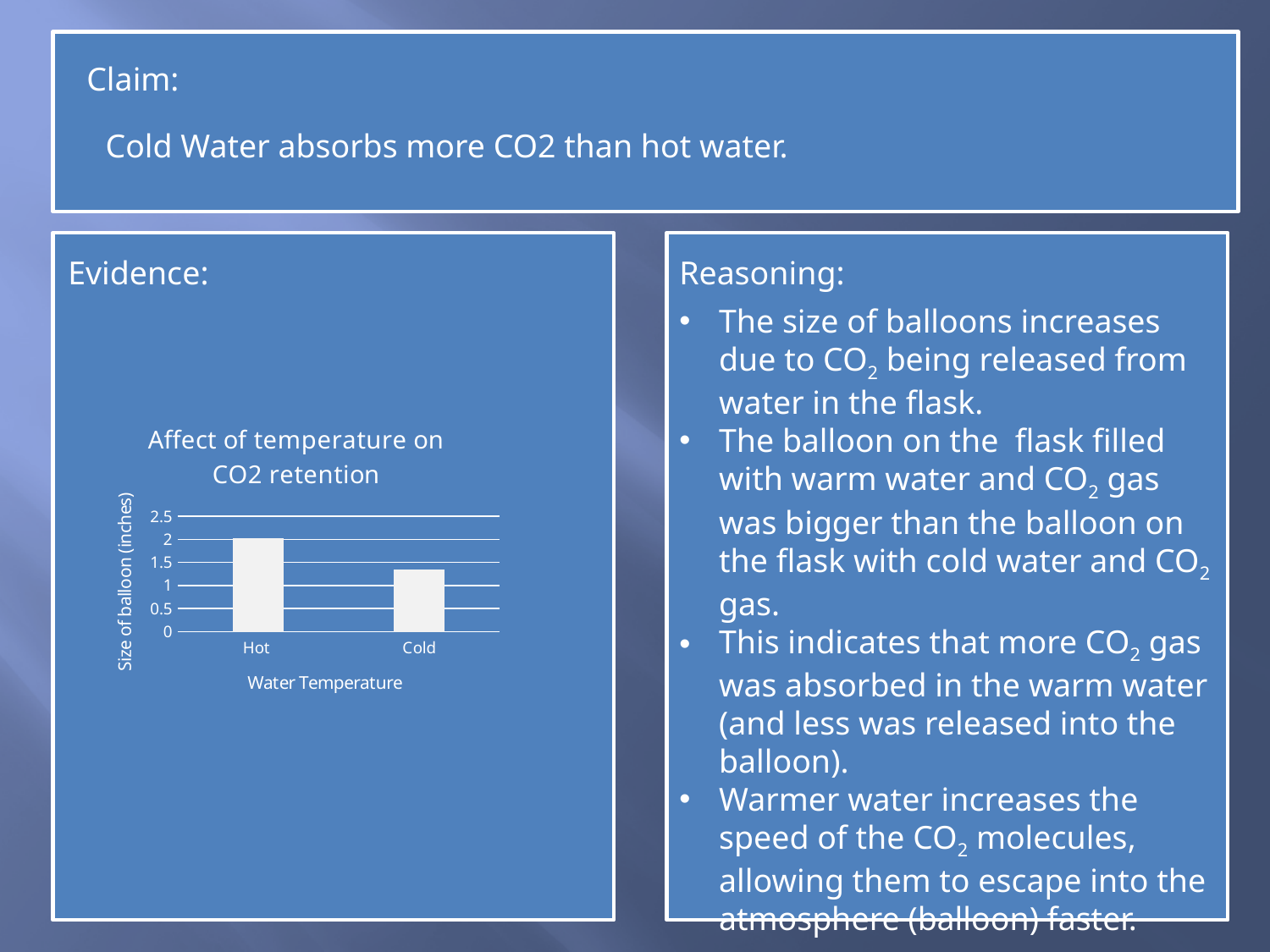
Do the values rise or fall moving from Hot to Cold along the x axis? fall Is the value for Hot greater or less than 1.5? greater Is the value for Cold greater or less than 1? greater Which water temperature has the larger balloon size in the chart? Hot How many categories are shown on the x axis of the chart? 2 Is the value for Cold greater or less than 1.5? less Which water temperature has the smaller balloon size in the chart? Cold What kind of chart is shown on the slide? bar chart What is the title of the chart? Affect of temperature on CO2 retention Is the balloon size for Hot water larger or smaller than for Cold water? larger What is the label of the chart's y axis? Size of balloon (inches)